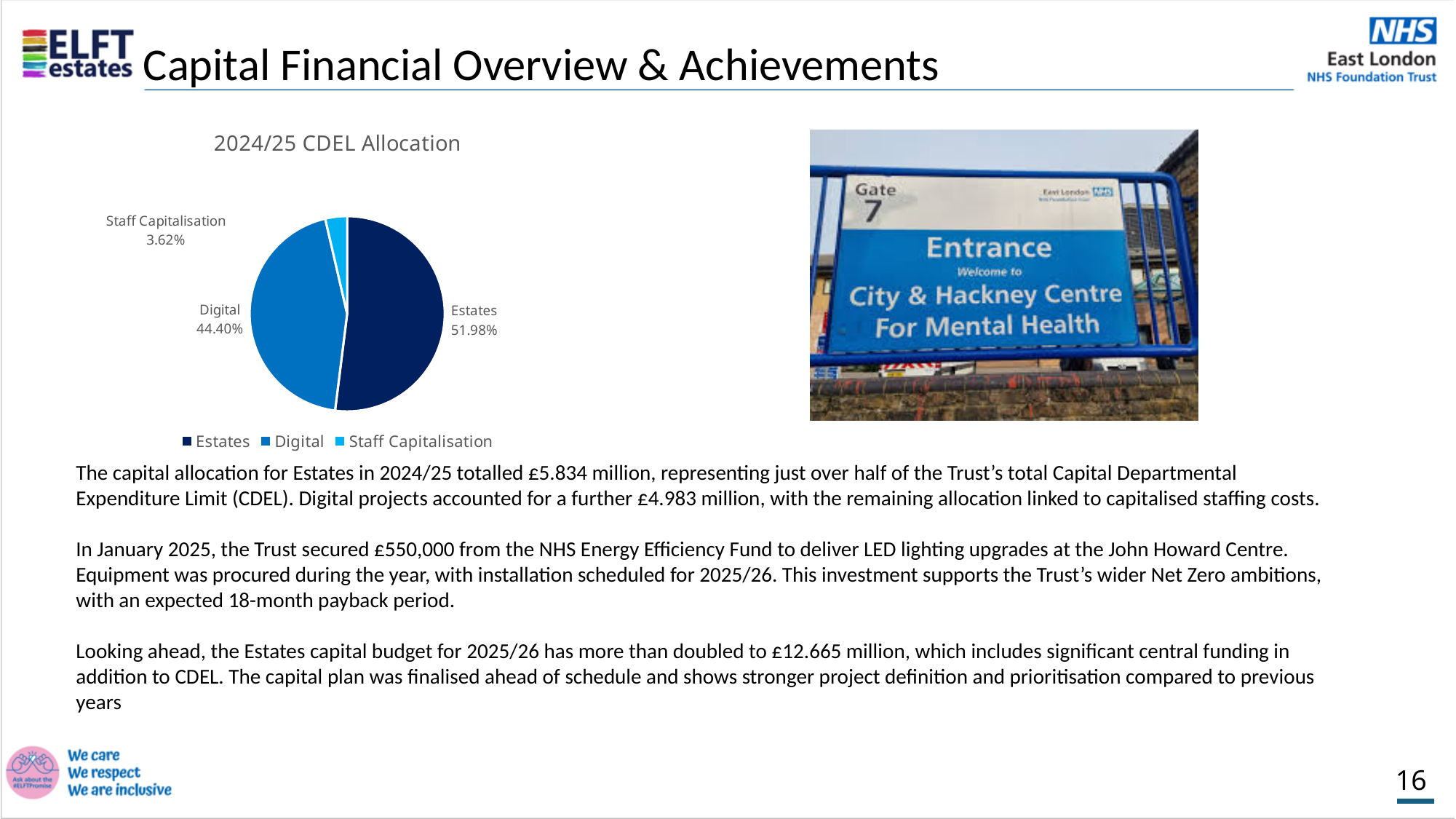
What is the title of the chart? 2024/25 CDEL Allocation Which category is shown in the lightest blue colour in the legend? Staff Capitalisation What is the difference in percentage points between the Estates and Digital shares? 7.58 percentage points Which is larger, the Digital share or the Staff Capitalisation share? Digital What kind of chart is shown on the slide? Pie chart How many categories are shown in the pie chart? 3 What share of the 2024/25 CDEL allocation goes to Digital? 44.40% Which category has the largest slice of the pie? Estates Which category has the smallest slice of the pie? Staff Capitalisation What share of the 2024/25 CDEL allocation goes to Estates? 51.98% What share of the 2024/25 CDEL allocation goes to Staff Capitalisation? 3.62% How many entries does the legend list? 3